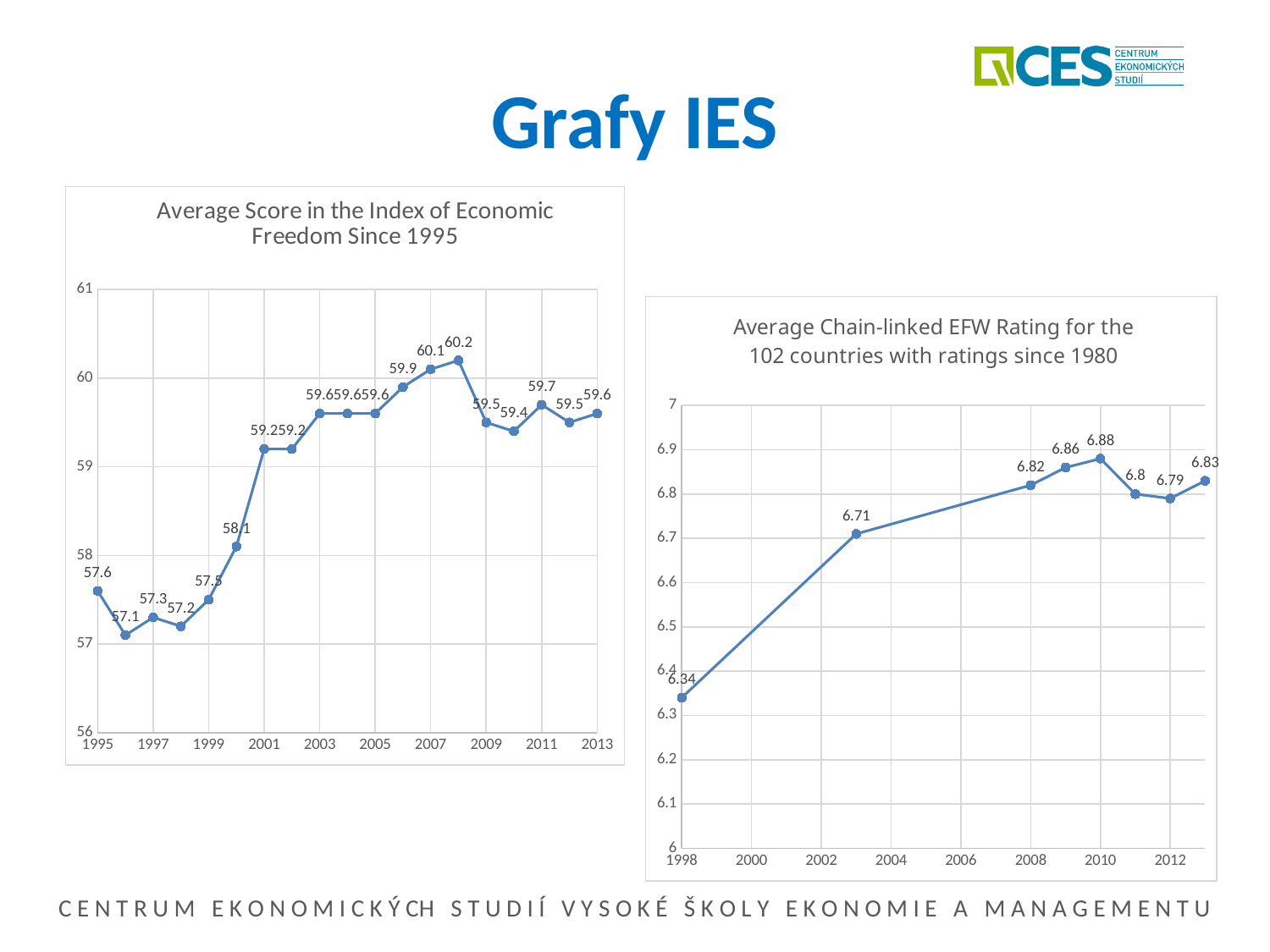
In the chart 'Average Chain-linked EFW Rating for the 102 countries with ratings since 1980', what is the value for 1998? 6.34 In the chart 'Average Score in the Index of Economic Freedom Since 1995', what is the difference between the values for 2008 and 1996? 3.1 In the chart 'Average Score in the Index of Economic Freedom Since 1995', what is the value for 2008? 60.2 In the chart 'Average Chain-linked EFW Rating for the 102 countries with ratings since 1980', which is larger, the value for 2009 or the value for 2012? 2009 In the chart 'Average Score in the Index of Economic Freedom Since 1995', is the value for 2000 greater or less than 58? greater In the chart 'Average Score in the Index of Economic Freedom Since 1995', which year has the lowest value? 1996 In the chart 'Average Score in the Index of Economic Freedom Since 1995', which year has the highest value? 2008 In the chart 'Average Chain-linked EFW Rating for the 102 countries with ratings since 1980', which year has the highest value? 2010 In the chart 'Average Chain-linked EFW Rating for the 102 countries with ratings since 1980', what is the difference between the values for 2003 and 1998? 0.37 What kind of chart is 'Average Score in the Index of Economic Freedom Since 1995'? line chart In the chart 'Average Chain-linked EFW Rating for the 102 countries with ratings since 1980', how many data points are plotted? 8 In the chart 'Average Score in the Index of Economic Freedom Since 1995', what is the value for 1995? 57.6